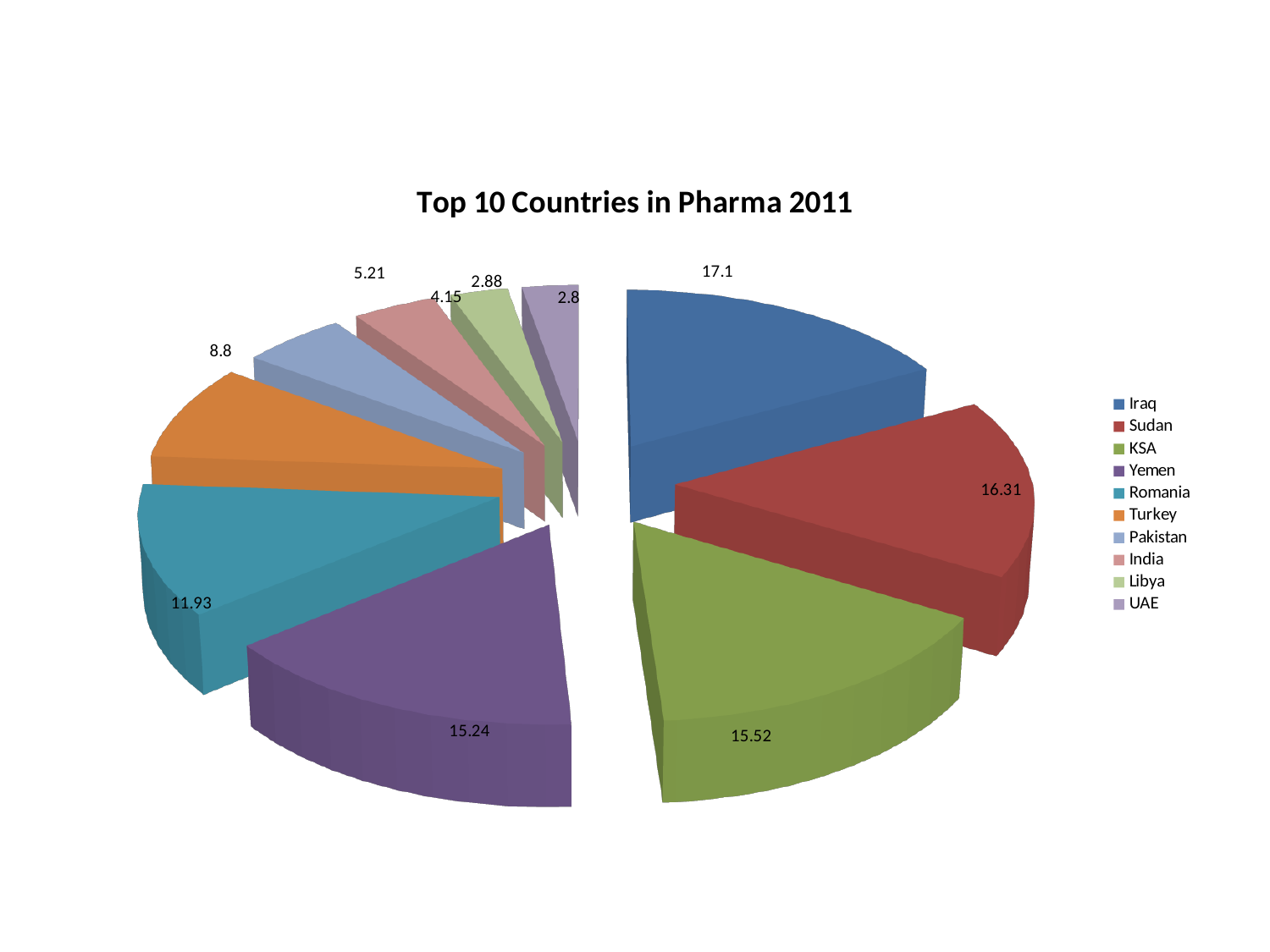
What is the value labelled for Libya? 2.88 What is the value labelled for Pakistan? 5.21 Which country has the largest slice of the pie? Iraq What is the title of the chart? Top 10 Countries in Pharma 2011 What type of chart is shown on the slide? Pie chart What colour is the slice for Turkey? Orange What is the difference between the values for Sudan and KSA? 0.79 What is the value labelled for Iraq? 17.1 What is the value labelled for Romania? 11.93 Which is larger, the value for Yemen or the value for Turkey? Yemen Which country has the smallest slice of the pie? UAE How many countries are shown in the pie chart? 10